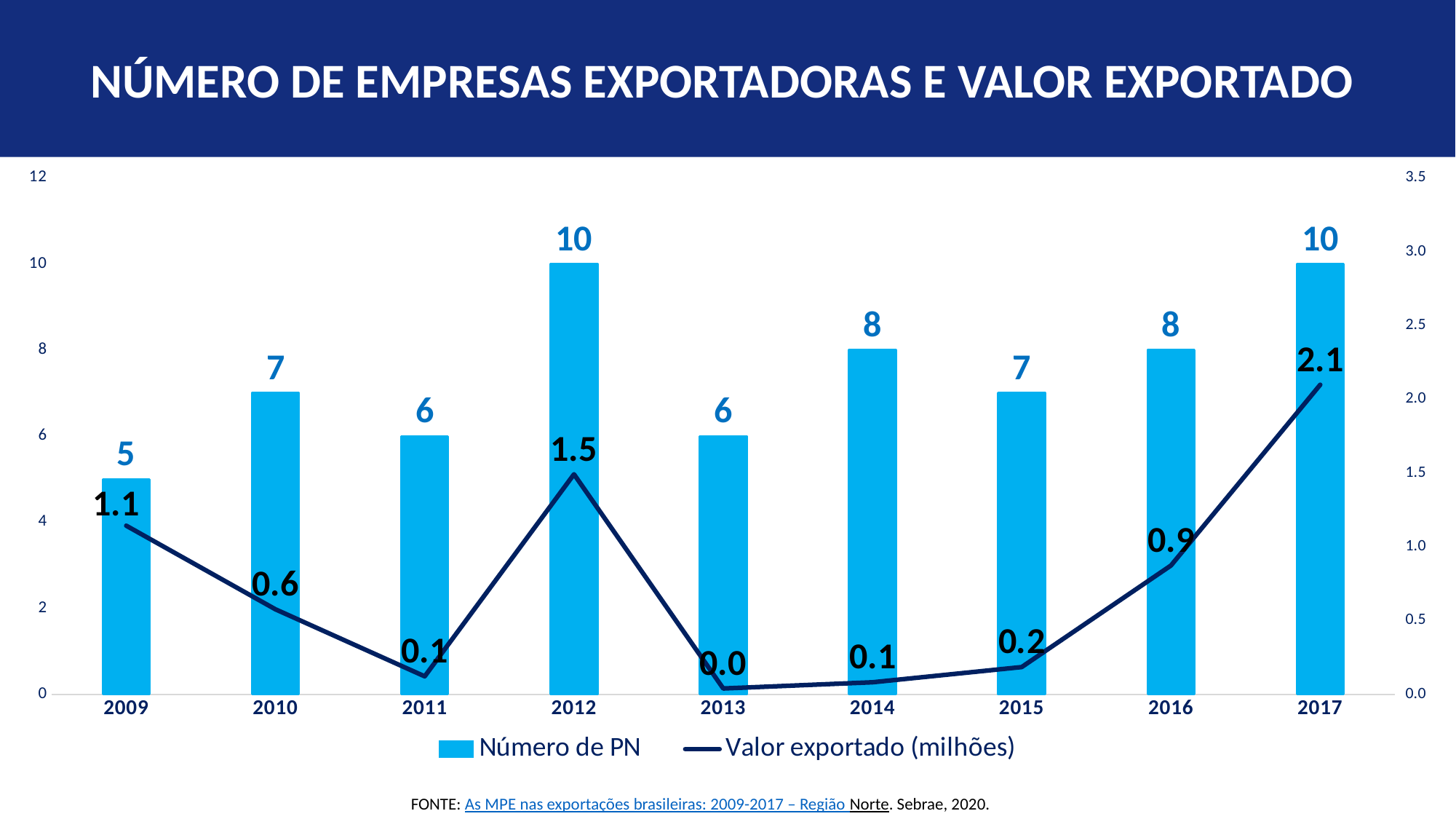
Does the Valor exportado (milhões) rise or fall from 2013 to 2017? Rise What kind of chart is shown on the slide? Combined bar and line chart What is the difference in Número de PN between 2012 and 2009? 5 What is the Valor exportado (milhões) for 2013? 0.0 Which is larger, the Número de PN for 2014 or for 2015? 2014 Which year has the lowest Número de PN? 2009 What is the Valor exportado (milhões) for 2017? 2.1 How many series does the legend list? 2 How many years are shown on the x axis? 9 Which year has the highest Valor exportado (milhões)? 2017 What is the difference in Valor exportado (milhões) between 2017 and 2012? 0.6 What is the value of Número de PN for 2012? 10